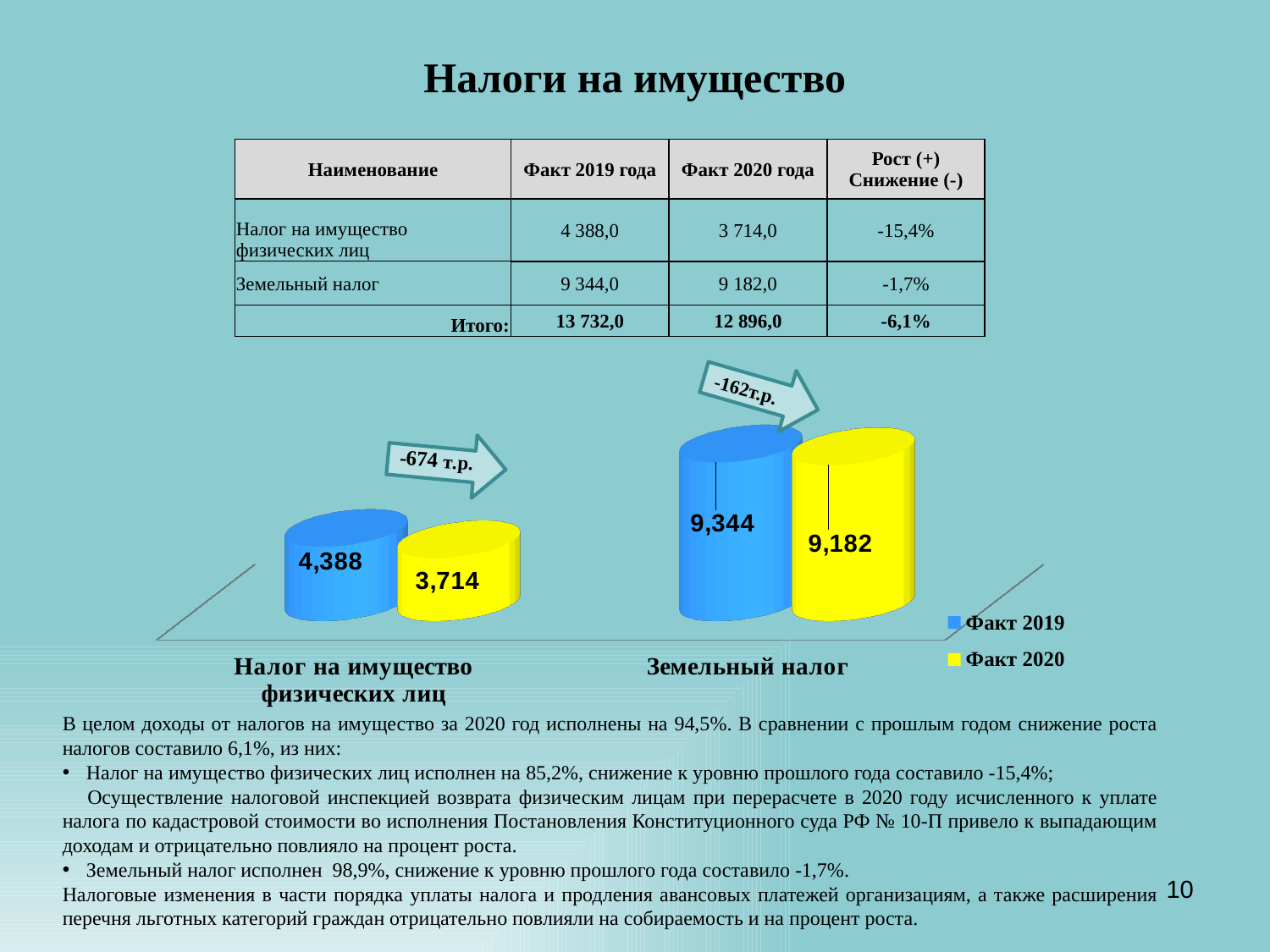
What is the value for Факт 2020 for Налог на имущество физических лиц? 3,714 Which category has the highest value in the Факт 2019 series? Земельный налог How many categories are shown on the chart? 2 What is the value for Факт 2020 for Земельный налог? 9,182 What kind of chart is shown on the slide? Bar chart Which is larger for Земельный налог: Факт 2019 or Факт 2020? Факт 2019 How many series does the chart legend list? 2 What is the difference between Факт 2019 and Факт 2020 for Земельный налог? 162 What is the value for Факт 2019 for Налог на имущество физических лиц? 4,388 Which category has the lowest value in the Факт 2020 series? Налог на имущество физических лиц What is the difference between Факт 2019 and Факт 2020 for Налог на имущество физических лиц? 674 What is the value for Факт 2019 for Земельный налог? 9,344